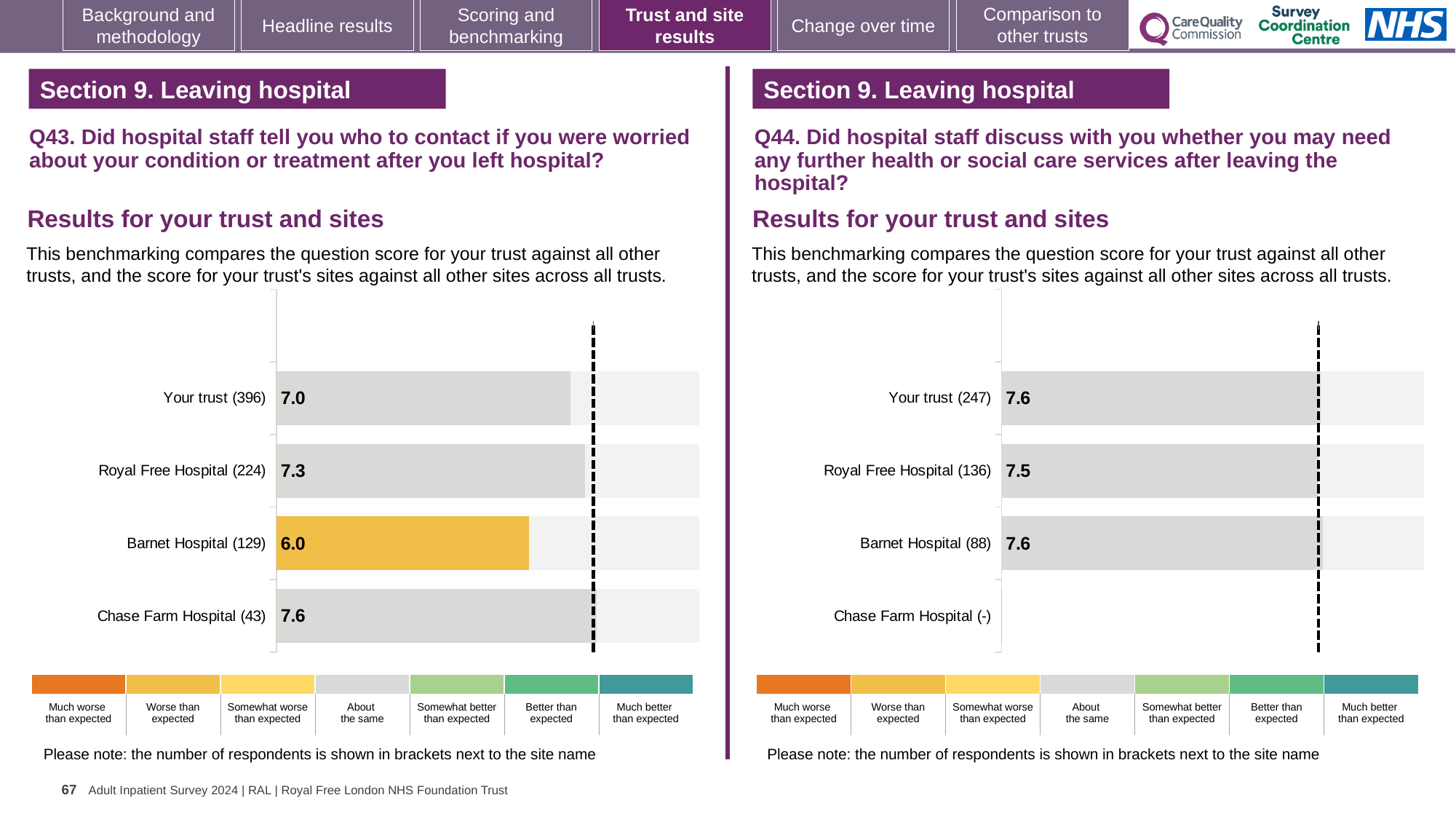
In the Q43 chart on the left, which benchmark category does the colour of the Barnet Hospital bar correspond to? Worse than expected In the Q43 chart on the left, which site has the highest score? Chase Farm Hospital In the Q43 chart on the left, what is the difference between the scores for Chase Farm Hospital and Barnet Hospital? 1.6 How many sites (including Your trust) are listed in the Q44 chart on the right? 4 What type of chart is used in the Q43 chart on the left? Bar chart In the Q44 chart on the right, what is the score for Royal Free Hospital? 7.5 In the Q43 chart on the left, what is the score for Barnet Hospital? 6.0 In the Q43 chart on the left, which has the higher score, Royal Free Hospital or Your trust? Royal Free Hospital In the Q43 chart on the left, how many respondents are shown in brackets for Chase Farm Hospital? 43 In the Q43 chart on the left, which site has the lowest score? Barnet Hospital In the Q43 chart on the left, what is the score for Your trust? 7.0 In the Q44 chart on the right, which has the higher score, Your trust or Royal Free Hospital? Your trust